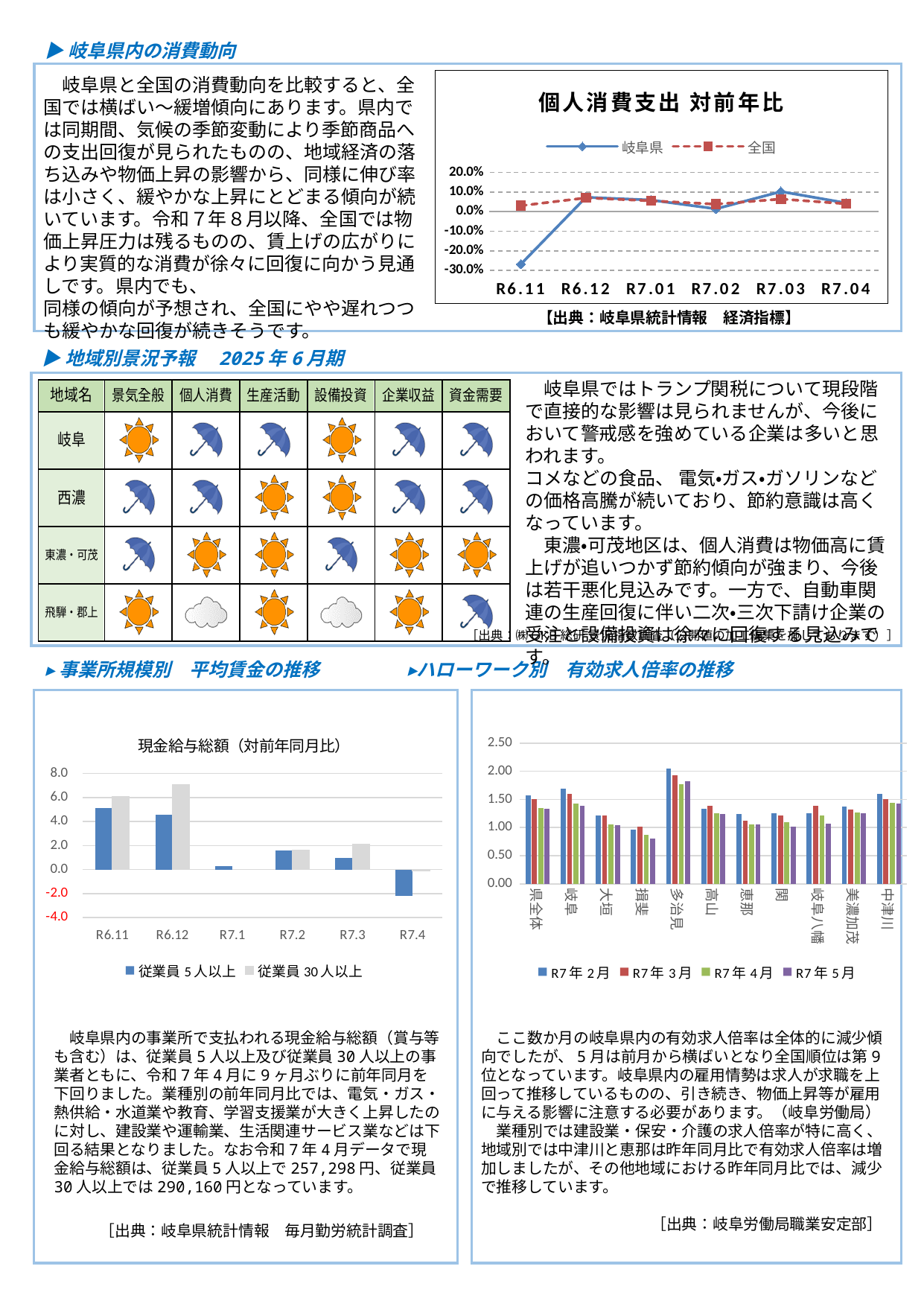
In the chart titled 個人消費支出 対前年比, how many series does the legend list? 2 In the chart titled 現金給与総額（対前年同月比）, is the value for 従業員5人以上 at R7.4 greater or less than 0.0? less In the chart titled 現金給与総額（対前年同月比）, at R6.12, which is larger: 従業員5人以上 or 従業員30人以上? 従業員30人以上 In the chart titled 個人消費支出 対前年比, what kind of chart is it? line chart In the chart titled 個人消費支出 対前年比, at which period is the 岐阜県 value lowest? R6.11 In the chart titled 現金給与総額（対前年同月比）, which period has the highest value for 従業員30人以上? R6.12 In the chart titled 個人消費支出 対前年比, how many points are plotted along the x axis? 6 In the bar chart under ハローワーク別 有効求人倍率の推移, is the value for 揖斐 in R7年5月 greater or less than 1.00? less In the bar chart under ハローワーク別 有効求人倍率の推移, which area has the highest value for R7年2月? 多治見 In the bar chart under ハローワーク別 有効求人倍率の推移, how many series does the legend list? 4 In the chart titled 個人消費支出 対前年比, is the 岐阜県 value at R6.11 greater or less than -20.0%? less In the chart titled 現金給与総額（対前年同月比）, what kind of chart is it? bar chart